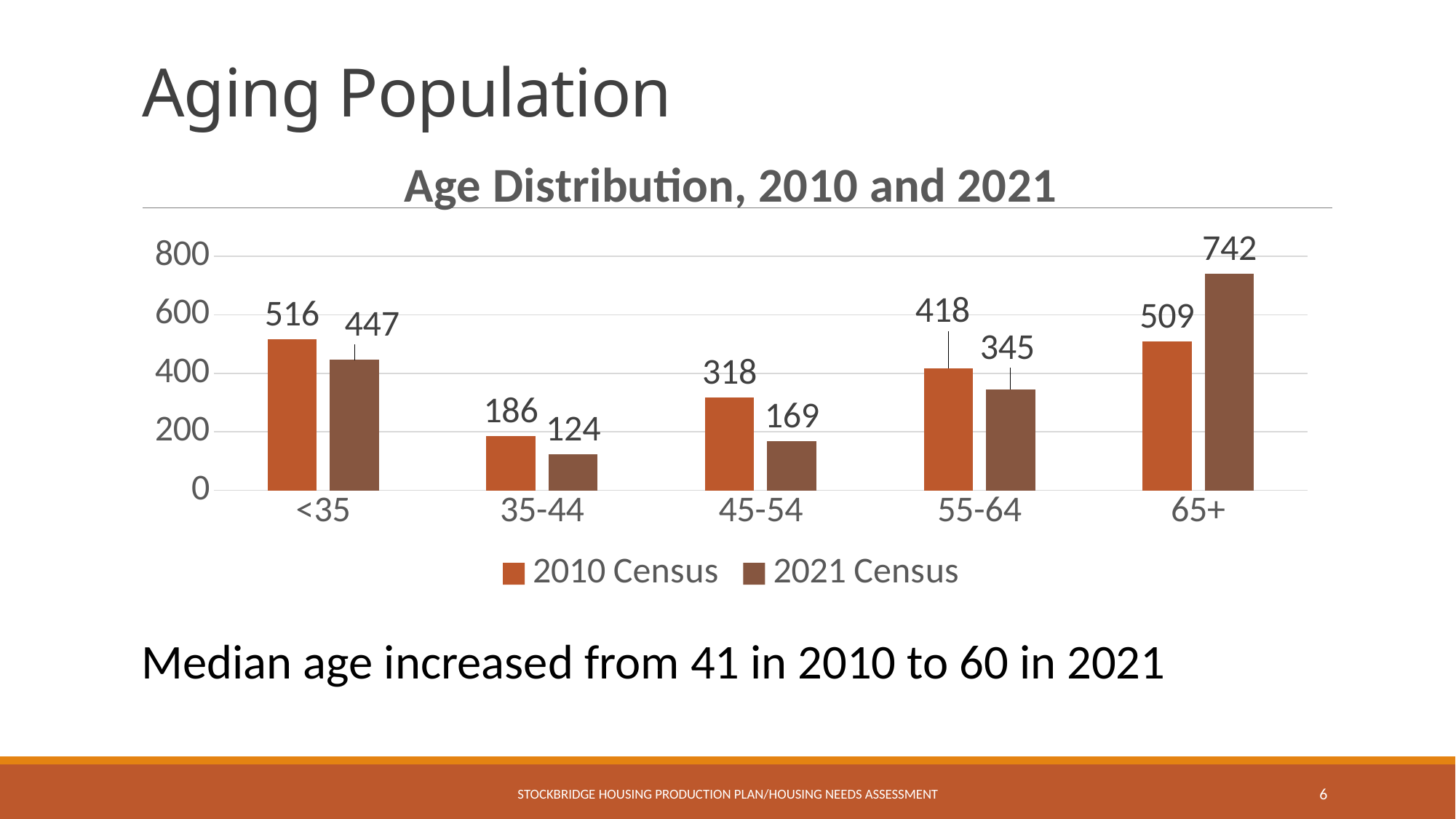
Which age group has the highest 2021 Census value? 65+ What is the title of the chart? Age Distribution, 2010 and 2021 How many series does the legend list? 2 What is the difference between the 2021 Census and 2010 Census values for the 65+ age group? 233 What is the 2021 Census value for the 45-54 age group? 169 What is the 2010 Census value for the <35 age group? 516 What kind of chart is shown on the slide? bar chart Which is larger for the 55-64 age group, the 2010 Census value or the 2021 Census value? 2010 Census Which age group has the lowest 2010 Census value? 35-44 What is the 2021 Census value for the 65+ age group? 742 Is the 2010 Census value for the 45-54 age group greater or less than 400? less How many age groups are shown on the x axis? 5